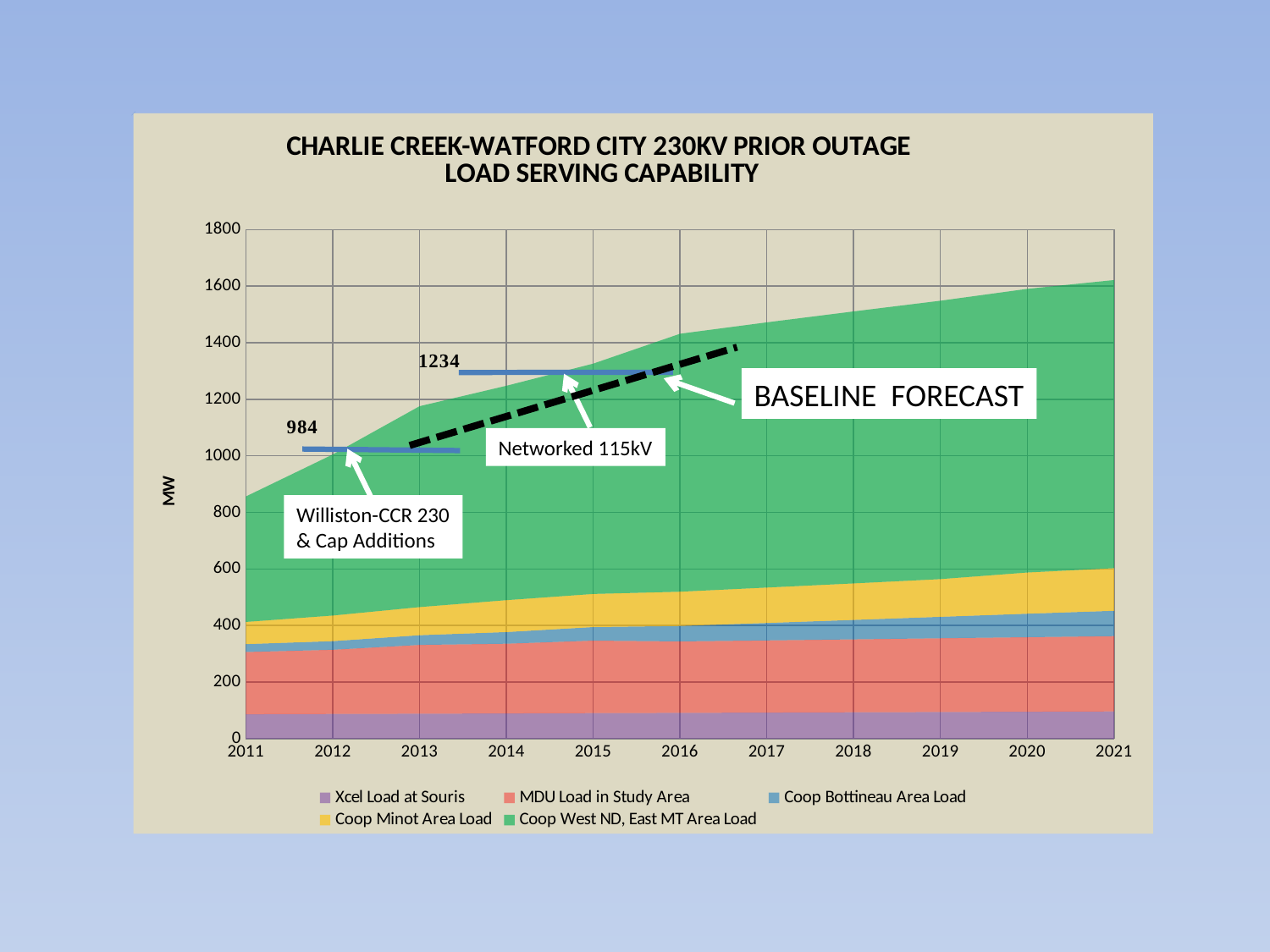
What is the difference between the Networked 115kV value (1234) and the Williston-CCR 230 & Cap Additions value (984)? 250 Is the total stacked load in 2011 greater or less than 800? greater How many series does the legend list? 5 How many years are labelled along the x axis? 11 Which series forms the largest band in the stacked area chart? Coop West ND, East MT Area Load What value is labelled on the Networked 115kV capability line? 1234 Is the total stacked load in 2021 greater or less than 1800? less What is the label on the y axis? MW Which labelled capability line is higher, Networked 115kV or Williston-CCR 230 & Cap Additions? Networked 115kV What value is labelled on the Williston-CCR 230 & Cap Additions capability line? 984 What kind of chart is shown on the slide? Stacked area chart Does the total stacked load rise or fall from 2011 to 2021? Rises